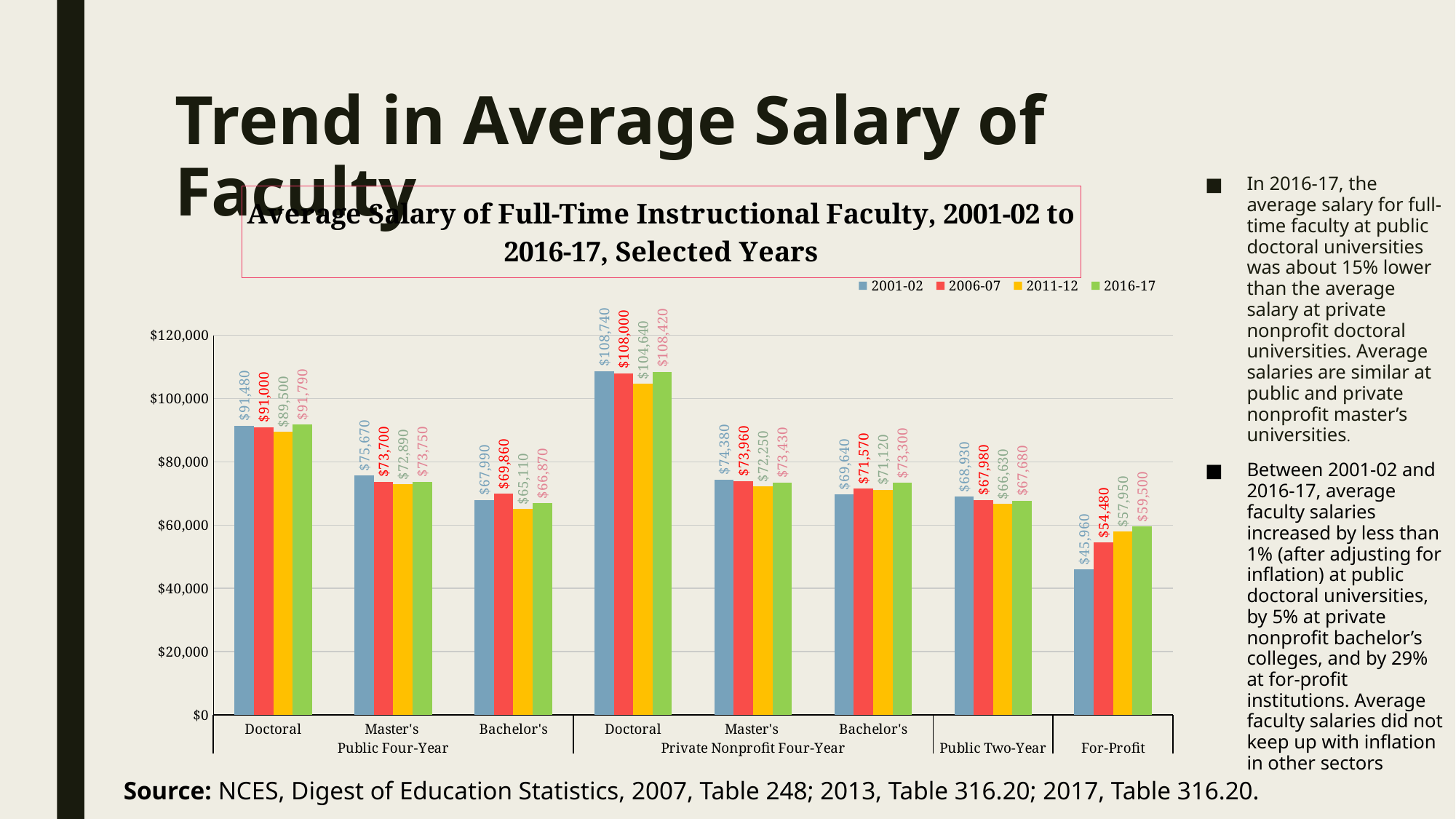
What is the 2001-02 average salary for Doctoral institutions in the Private Nonprofit Four-Year group? $108,740 Do the For-Profit average salaries rise or fall from 2001-02 to 2016-17? rise How many institution categories are shown on the x axis? 8 Is the 2001-02 average salary for Public Four-Year Doctoral institutions greater or less than $100,000? less Which category has the lowest 2001-02 average salary? For-Profit Which is larger: the 2016-17 average salary for Public Four-Year Master's or for Private Nonprofit Four-Year Master's? Public Four-Year Master's What is the difference between the 2016-17 and 2001-02 average salaries for For-Profit institutions? $13,540 What is the 2016-17 average salary for For-Profit institutions? $59,500 Which category has the highest 2016-17 average salary? Private Nonprofit Four-Year Doctoral What is the 2011-12 average salary for Public Two-Year institutions? $66,630 What kind of chart is shown on the slide? bar chart How many series does the legend list? 4